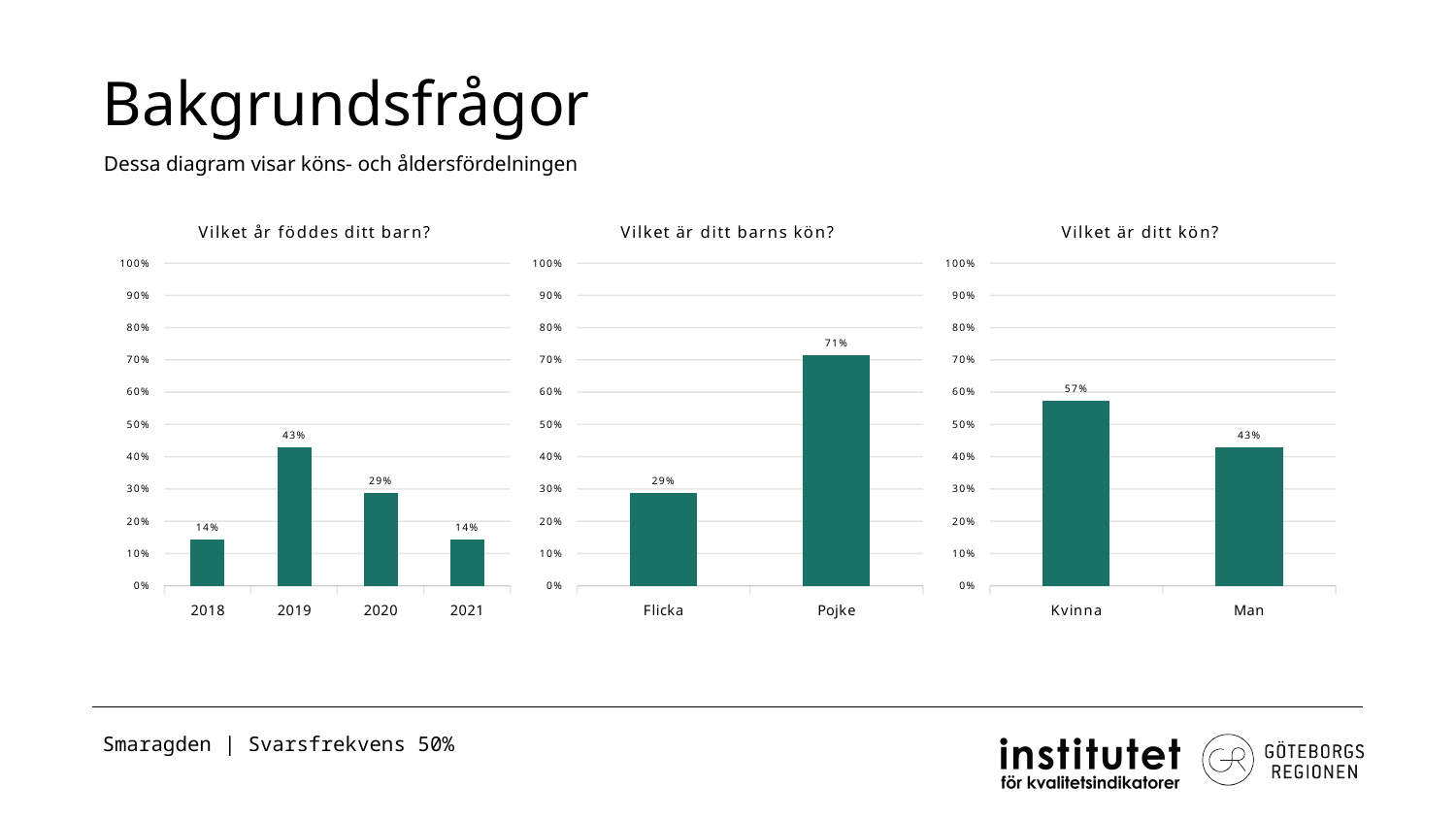
In the chart 'Vilket är ditt barns kön?', what is the value for Pojke? 71% In the chart 'Vilket år föddes ditt barn?', what is the value for 2019? 43% In the chart 'Vilket år föddes ditt barn?', which year has the highest value? 2019 In the chart 'Vilket är ditt kön?', which is larger, Kvinna or Man? Kvinna In the chart 'Vilket år föddes ditt barn?', how many years are shown on the x axis? 4 In the chart 'Vilket är ditt barns kön?', which category has the lowest value? Flicka In the chart 'Vilket år föddes ditt barn?', what is the difference between the values for 2019 and 2020? 14% In the chart 'Vilket är ditt kön?', what is the value for Kvinna? 57% What kind of chart is 'Vilket är ditt kön?'? Bar chart In the chart 'Vilket är ditt barns kön?', what is the difference between Pojke and Flicka? 42% In the chart 'Vilket är ditt kön?', is the value for Man greater or less than 50%? less In the chart 'Vilket år föddes ditt barn?', what is the value for 2020? 29%